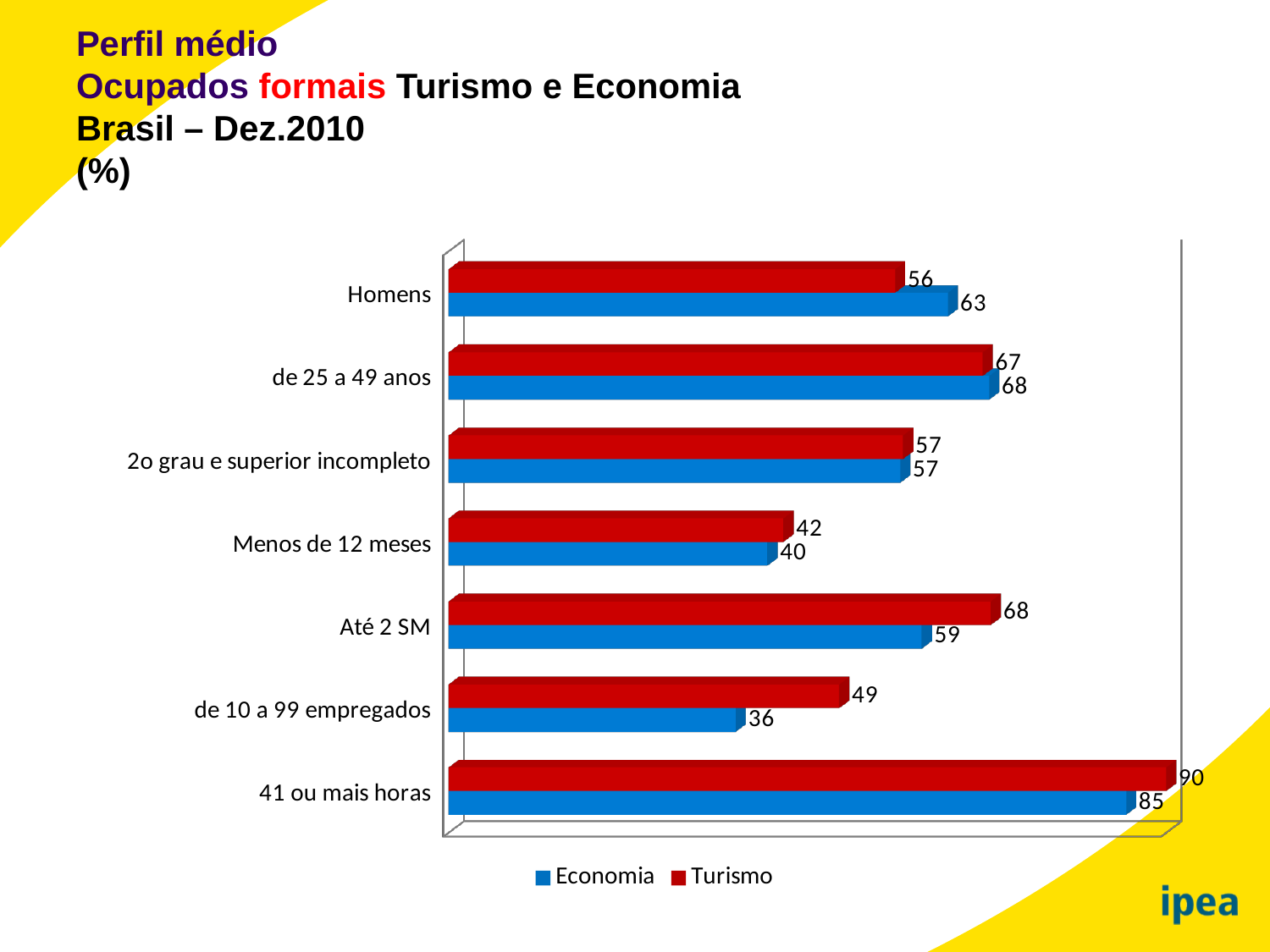
What is the difference between the Turismo and Economia values for "de 10 a 99 empregados"? 13 What is the difference between the Turismo and Economia values for "41 ou mais horas"? 5 How many series does the legend list? 2 How many categories are shown on the chart? 7 For "Homens", which series has the larger value, Economia or Turismo? Economia What kind of chart is shown on the slide? Bar chart What is the Turismo value for "Até 2 SM"? 68 Which category has the lowest Economia value? de 10 a 99 empregados What is the Turismo value for "Homens"? 56 What is the Economia value for "de 10 a 99 empregados"? 36 For "Até 2 SM", which series has the larger value, Economia or Turismo? Turismo Which category has the highest Turismo value? 41 ou mais horas